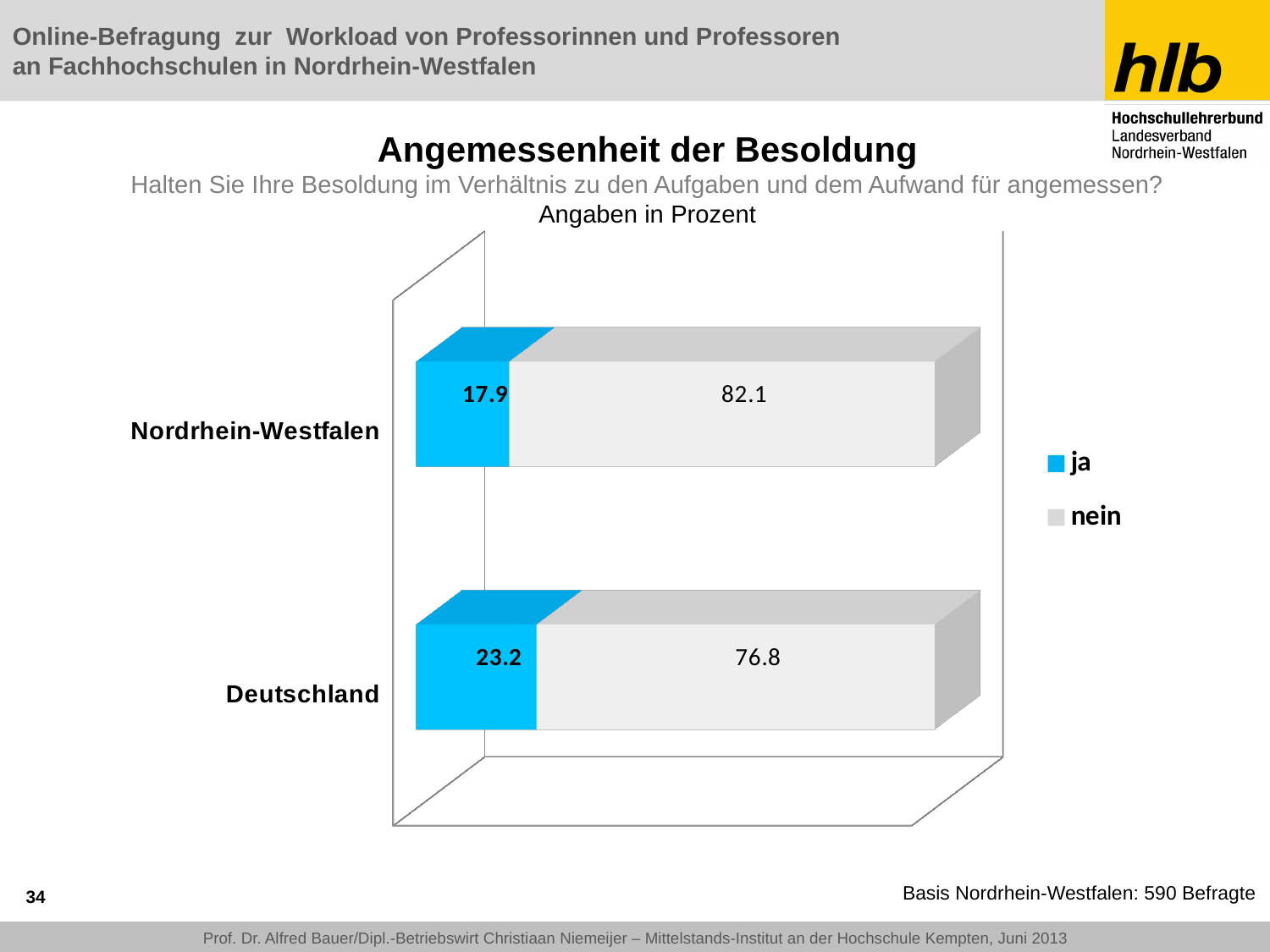
What kind of chart is shown on the slide? Stacked bar chart How many series does the legend list? 2 What is the value for "ja" for Deutschland? 23.2 How many categories are shown in the chart? 2 What is the difference between the "nein" and "ja" values for Nordrhein-Westfalen? 64.2 What is the value for "nein" for Nordrhein-Westfalen? 82.1 What is the total of the stacked bar for Deutschland? 100 What is the difference between the "ja" values for Deutschland and Nordrhein-Westfalen? 5.3 Which category has the higher "ja" value, Nordrhein-Westfalen or Deutschland? Deutschland What is the value for "ja" for Nordrhein-Westfalen? 17.9 What is the value for "nein" for Deutschland? 76.8 Which category has the highest "nein" value? Nordrhein-Westfalen